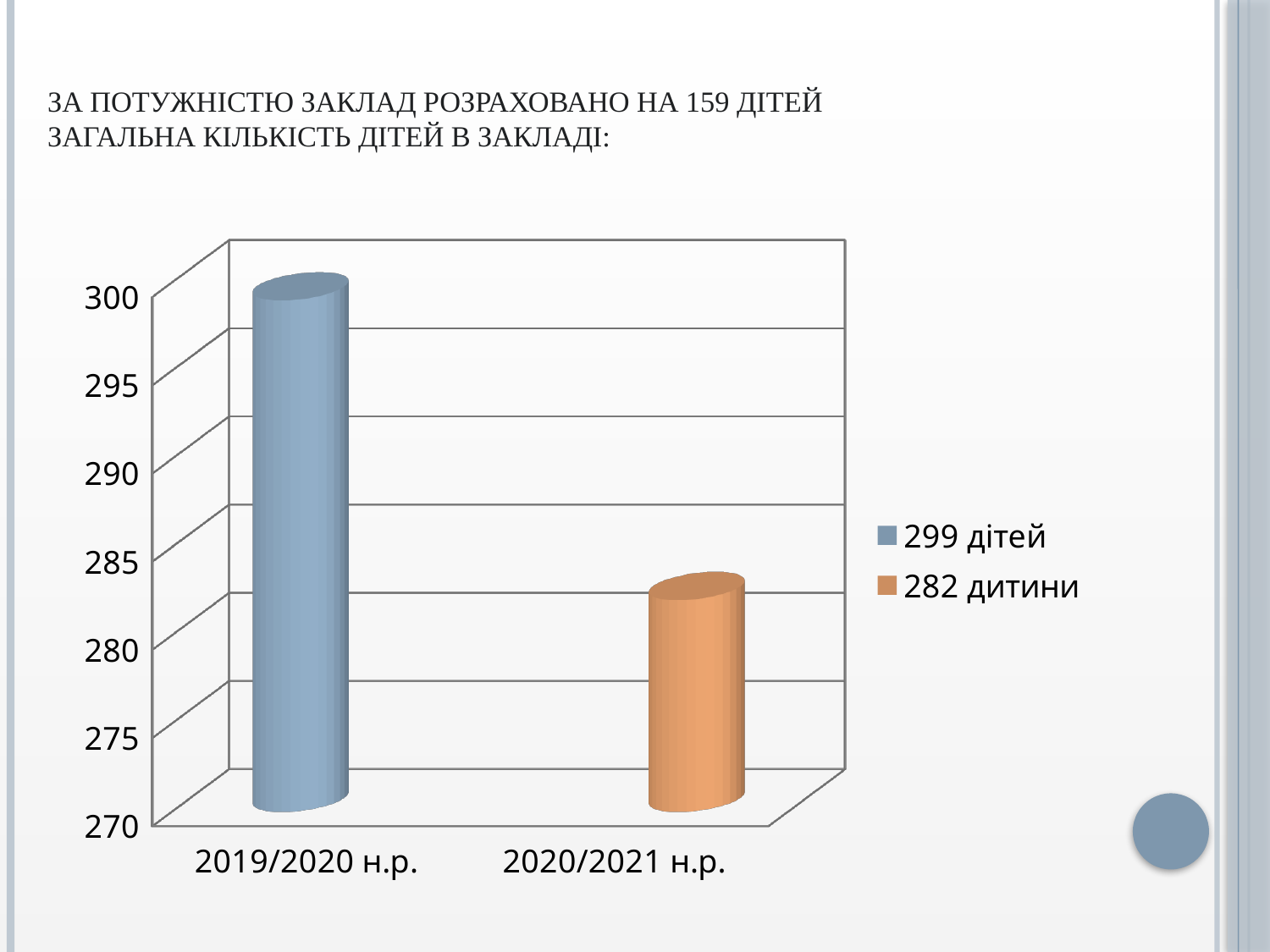
Is the value for 2019/2020 н.р. greater or less than 295? greater What legend entry corresponds to the orange bar in the chart? 282 дитини What legend entry corresponds to the blue bar in the chart? 299 дітей What is the difference between the number of children in 2019/2020 н.р. (299) and in 2020/2021 н.р. (282)? 17 Do the values rise or fall from 2019/2020 н.р. to 2020/2021 н.р.? fall How many categories are shown on the x axis of the chart? 2 Which is larger, the bar for 2019/2020 н.р. or the bar for 2020/2021 н.р.? 2019/2020 н.р. How many series does the chart legend list? 2 Which category has the highest bar in the chart? 2019/2020 н.р. What kind of chart is shown on the slide? bar chart Which category has the lowest bar in the chart? 2020/2021 н.р. Is the value for 2020/2021 н.р. greater or less than 285? less